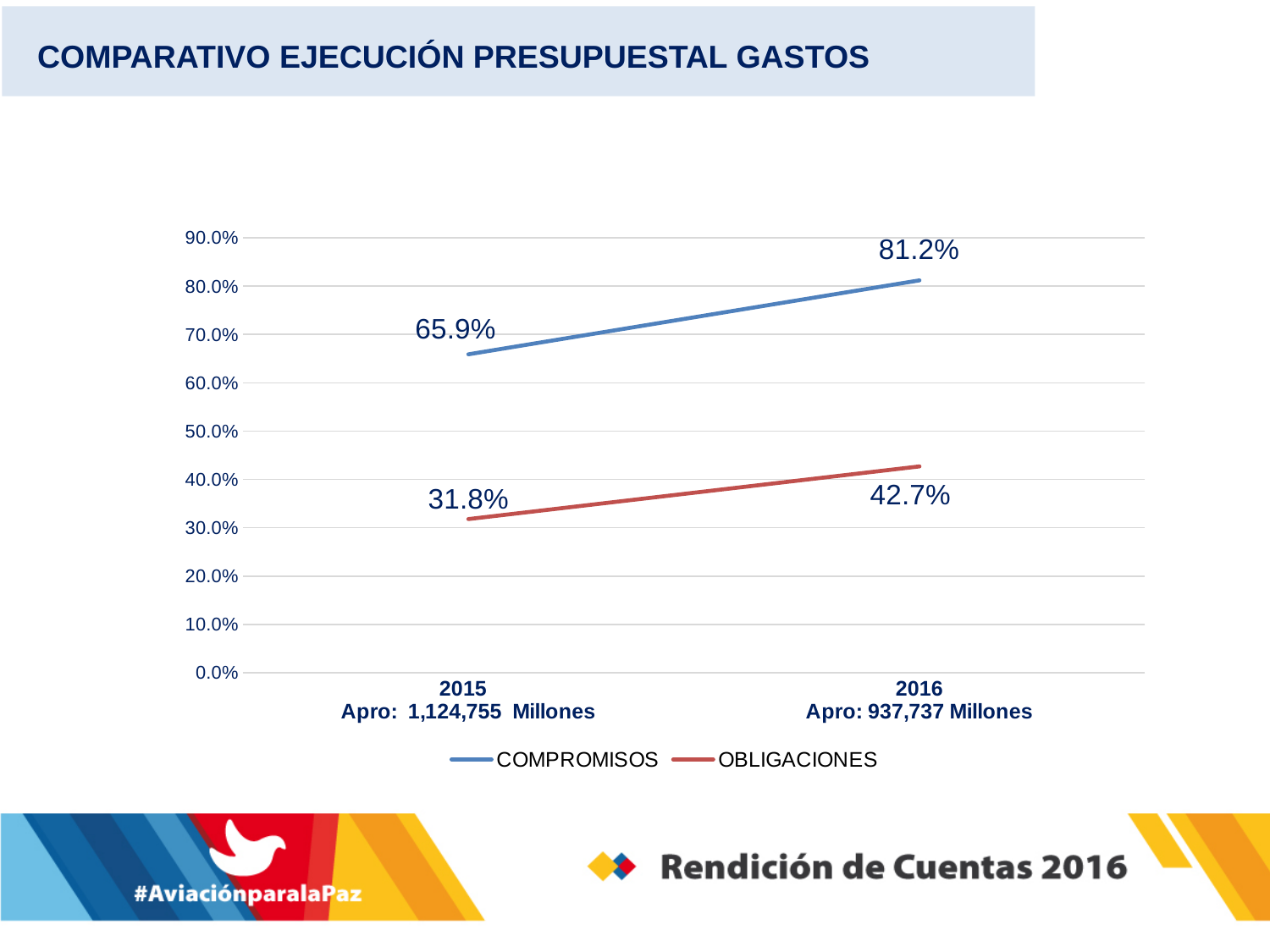
What is the OBLIGACIONES value for 2015? 31.8% How many series does the legend list? 2 What is the OBLIGACIONES value for 2016? 42.7% Which year has the higher COMPROMISOS value? 2016 Which series has the larger value in 2015, COMPROMISOS or OBLIGACIONES? COMPROMISOS What is the difference between the COMPROMISOS and OBLIGACIONES values in 2016? 38.5% What is the difference between the COMPROMISOS values for 2016 and 2015? 15.3% Which year has the lower OBLIGACIONES value? 2015 Do the OBLIGACIONES values rise or fall from 2015 to 2016? Rise What kind of chart is shown on the slide? Line chart What is the COMPROMISOS value for 2015? 65.9% What is the COMPROMISOS value for 2016? 81.2%